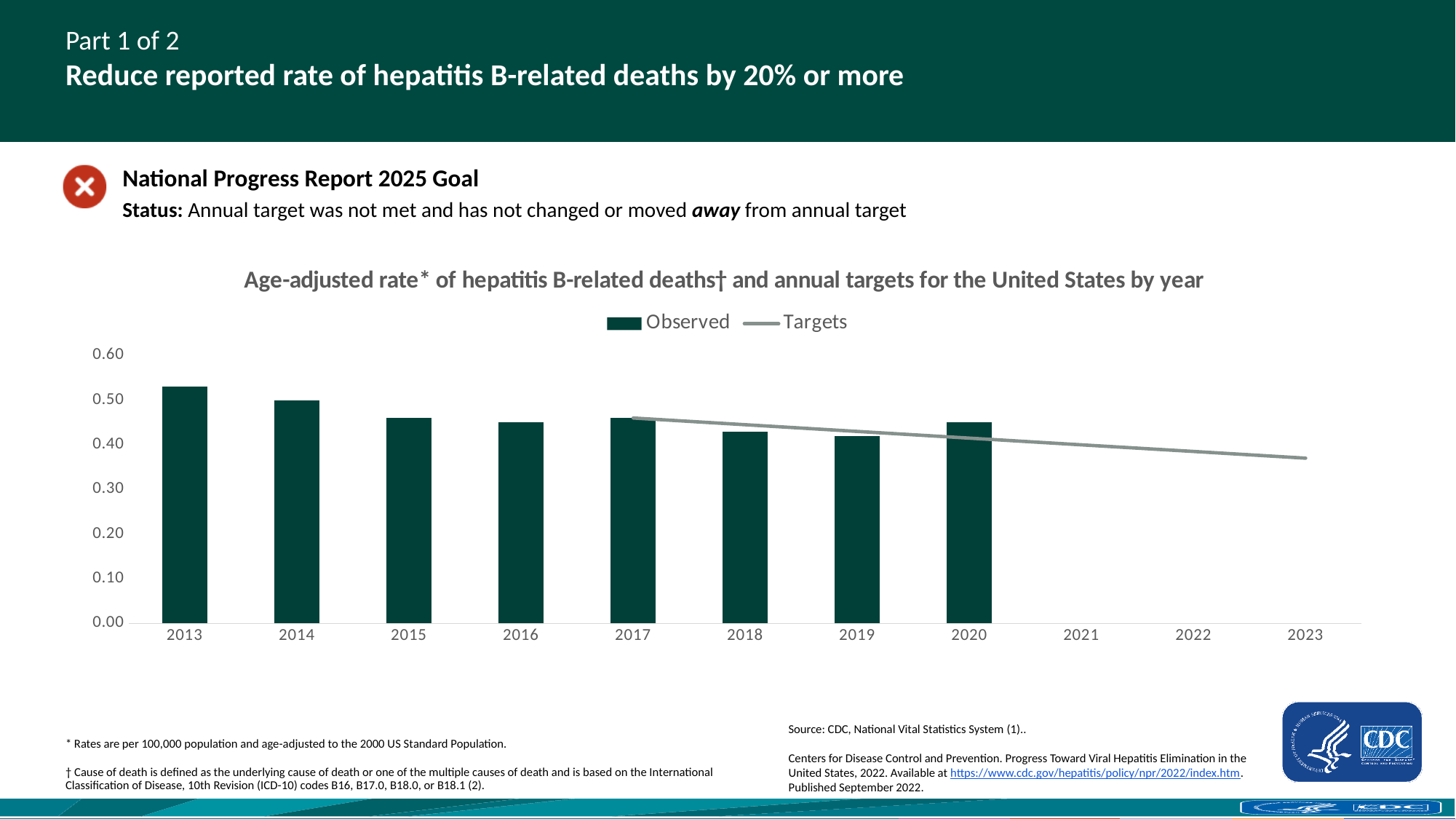
Do the Observed values generally rise or fall from 2013 to 2019? fall How many years are labelled on the x axis of the chart? 11 What kind of chart is shown on the slide? Bar chart with a line How many years have an Observed bar in the chart? 8 Is the Observed value for 2013 greater or less than 0.50? greater How many series does the chart legend list? 2 What are the two series named in the chart legend? Observed and Targets In which year does the Targets line begin? 2017 Is the Observed value for 2018 greater or less than 0.40? greater Is the Observed value for 2019 greater or less than 0.50? less Which is larger, the Observed value for 2013 or for 2014? 2013 Which year has the highest Observed bar? 2013